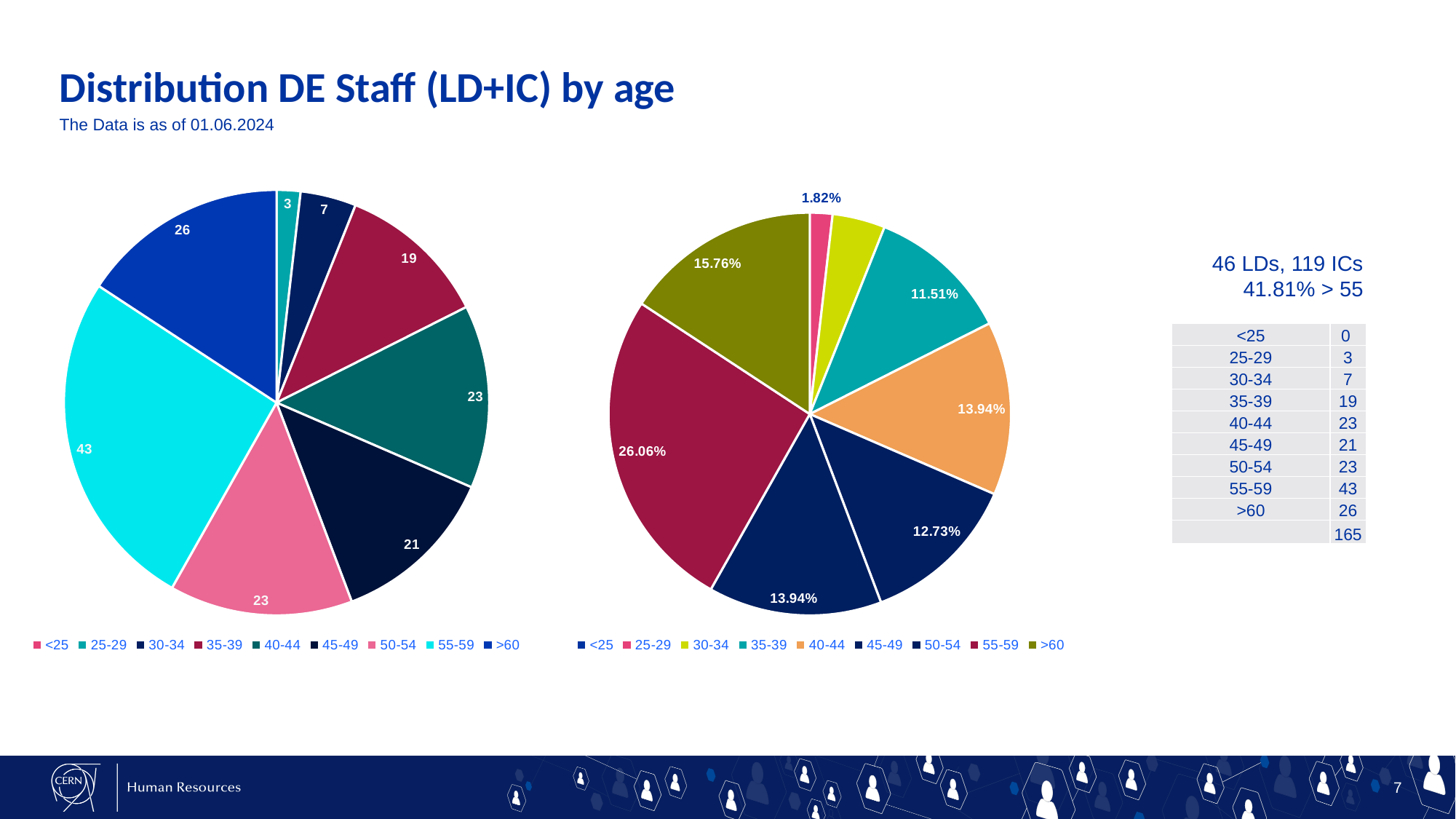
On the left pie chart, which is larger, the value for 35-39 or the value for 45-49? 45-49 What kind of chart is used on the left side of the slide? Pie chart How many age groups does the legend of the left pie chart list? 9 On the left pie chart, which age group has the largest slice? 55-59 On the right pie chart, what percentage is shown for the 55-59 age group? 26.06% On the left pie chart, what is the value for the >60 age group? 26 On the right pie chart, which age group has the smallest labelled percentage? 25-29 On the left pie chart, what is the value for the 55-59 age group? 43 On the right pie chart, what percentage is shown for the >60 age group? 15.76% On the left pie chart, what is the difference between the values for 55-59 and >60? 17 On the left pie chart, what is the value for the 30-34 age group? 7 On the right pie chart, what percentage is shown for the 35-39 age group? 11.51%